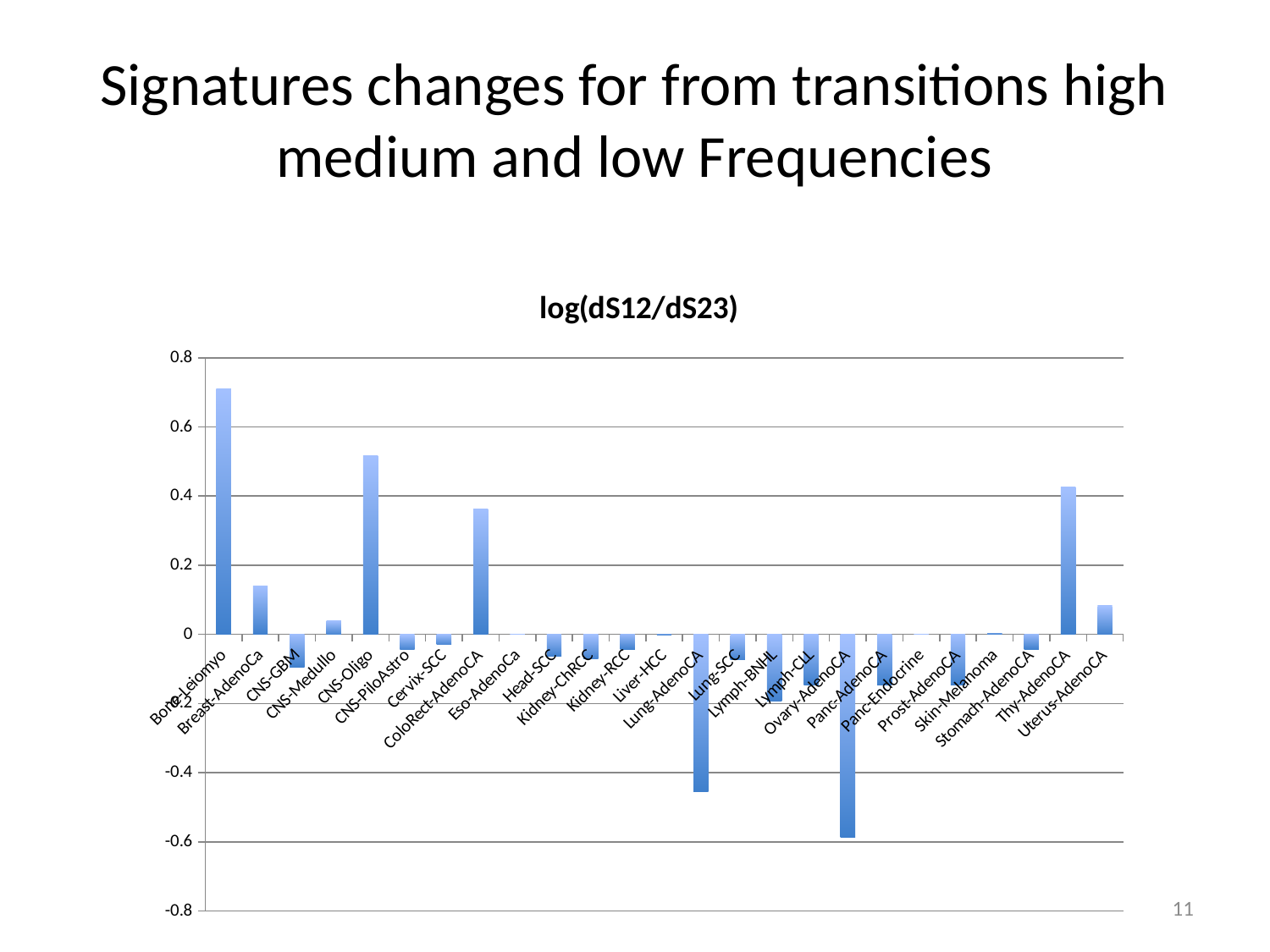
Which category has the lowest value in the chart? Ovary-AdenoCA Which category has the highest value in the chart? Bone-Leiomyo What is the title of the chart? log(dS12/dS23) Is the value for Ovary-AdenoCA greater or less than -0.4? less Which has the larger value, Bone-Leiomyo or CNS-Oligo? Bone-Leiomyo Is the value for CNS-Oligo greater or less than 0.4? greater What kind of chart is shown on the slide? bar chart Is the value for Bone-Leiomyo greater or less than 0.6? greater How many categories are plotted on the x axis of the chart? 25 Which has the lower value, Ovary-AdenoCA or Lung-AdenoCA? Ovary-AdenoCA